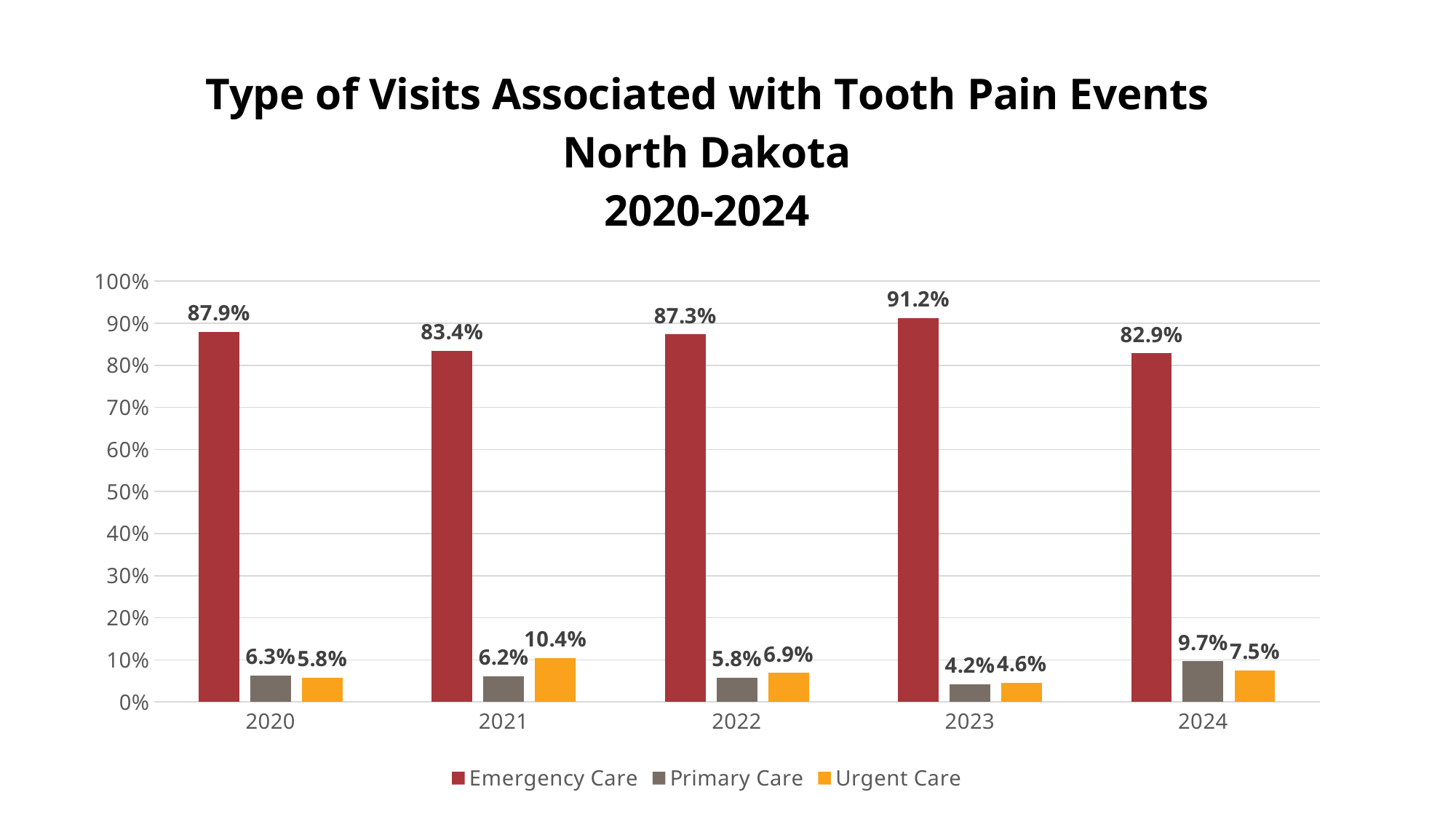
How many years are shown on the x axis? 5 In which year is the Emergency Care value lowest? 2024 Is the Emergency Care value for 2021 greater or less than 90%? less In which year is the Emergency Care value highest? 2023 What is the difference between the Emergency Care values for 2023 and 2024? 8.3% What is the Primary Care value for 2024? 9.7% Which series is shown in orange in the legend? Urgent Care Which is larger in 2022, Primary Care or Urgent Care? Urgent Care What is the Urgent Care value for 2021? 10.4% How many series does the legend list? 3 What kind of chart is shown on the slide? Bar chart What is the Emergency Care value for 2023? 91.2%